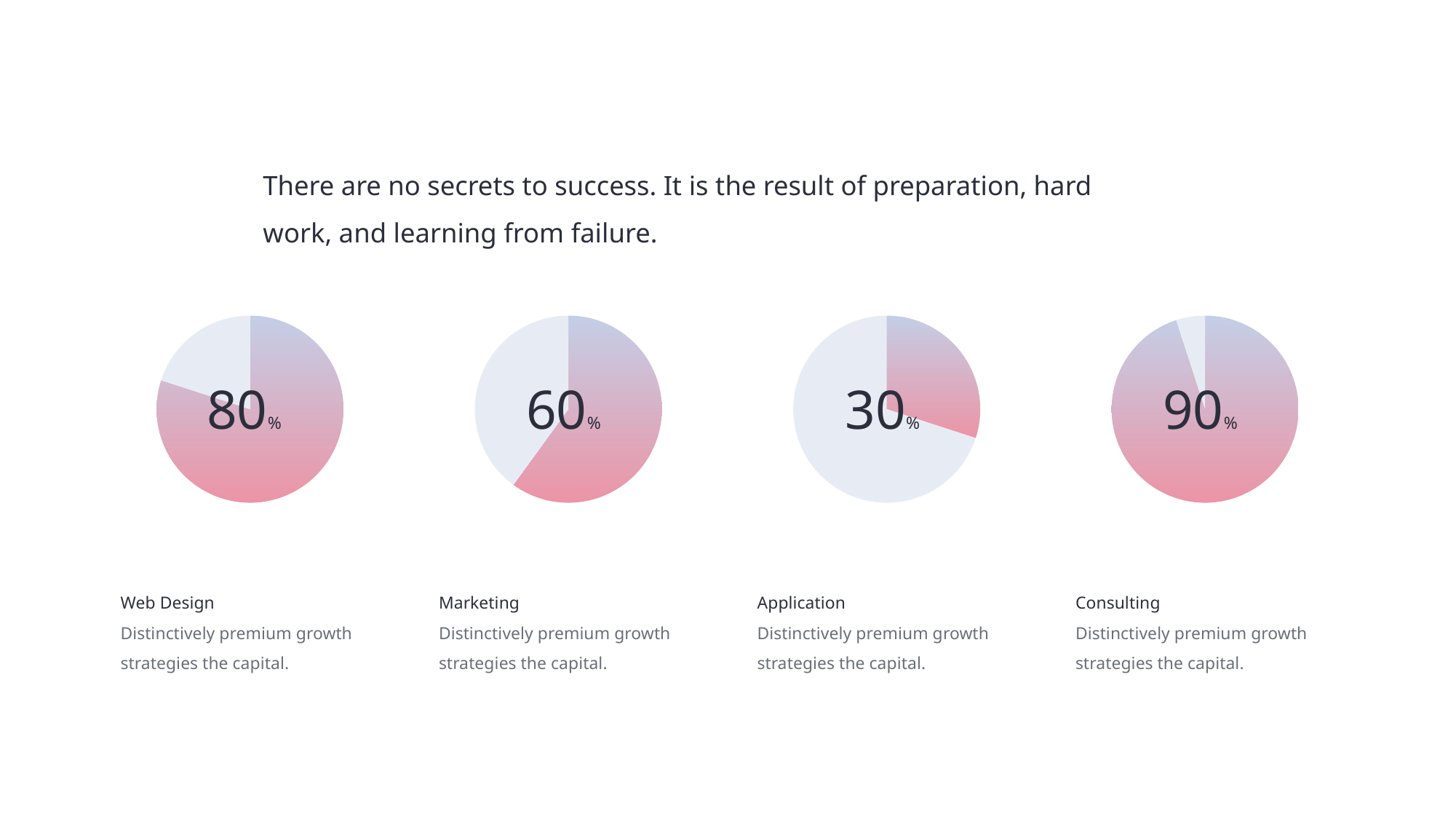
What percentage is shown on the Application pie chart? 30% What percentage is shown on the Web Design pie chart? 80% Which is larger, the Marketing percentage or the Application percentage? Marketing What is the difference between the Web Design percentage and the Marketing percentage? 20% What percentage is shown on the Marketing pie chart? 60% What kind of chart is used for Web Design, Marketing, Application and Consulting? Pie chart What share of the Application pie chart is filled by the coloured slice? 30% What percentage is shown on the Consulting pie chart? 90% Which of the four pie charts shows the highest percentage? Consulting What is the difference between the Consulting percentage and the Application percentage? 60% Which of the four pie charts shows the lowest percentage? Application How many pie charts are shown on the slide? 4